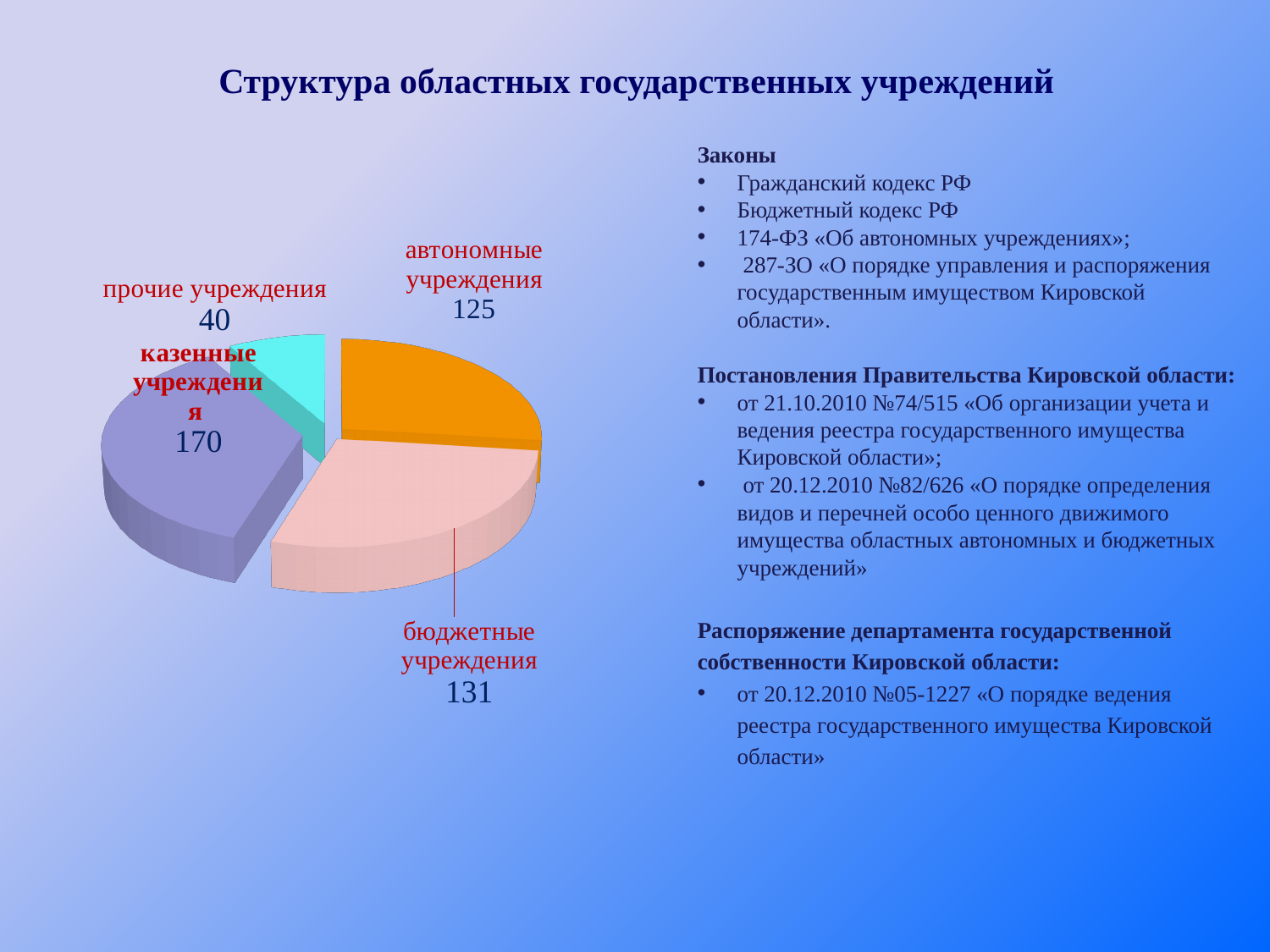
What is the value for бюджетные учреждения? 131 What is the title of the slide containing the pie chart? Структура областных государственных учреждений How many slices does the pie chart have? 4 Which category has the largest slice of the pie? казенные учреждения What type of chart is shown on the slide? pie chart What is the value for автономные учреждения? 125 What is the value for прочие учреждения? 40 What is the value for казенные учреждения? 170 What is the difference between the values for казенные учреждения and бюджетные учреждения? 39 Which category has the smallest slice of the pie? прочие учреждения What is the total of all slices in the pie chart? 466 Which is larger, the value for бюджетные учреждения or автономные учреждения? бюджетные учреждения